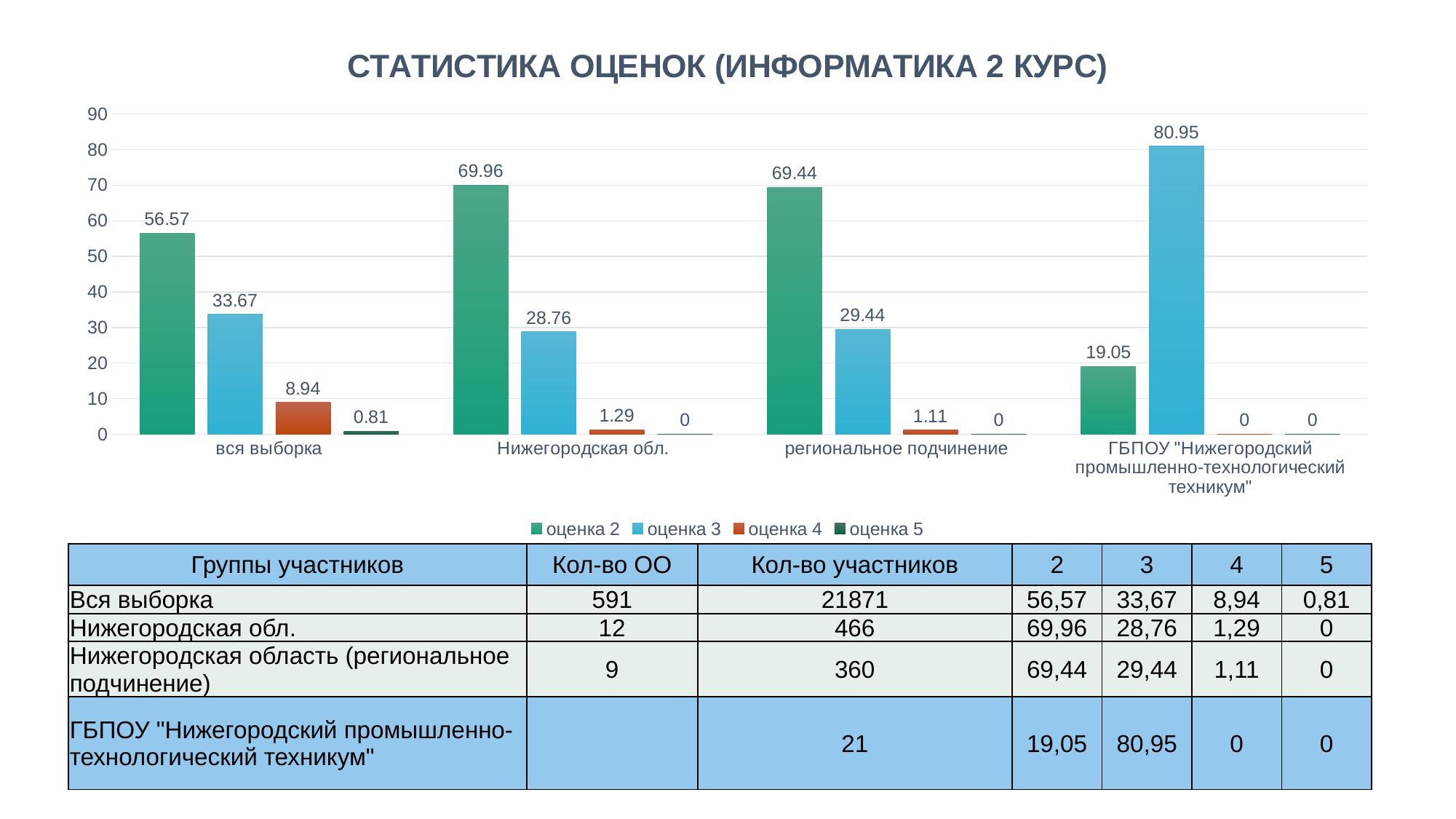
What is the difference between оценка 2 and оценка 3 for региональное подчинение? 40 What kind of chart is shown on the slide? bar chart What is the value of оценка 3 for ГБПОУ "Нижегородский промышленно-технологический техникум"? 80.95 What is the value of оценка 5 for вся выборка? 0.81 Which category has the lowest value for оценка 2? ГБПОУ "Нижегородский промышленно-технологический техникум" How many categories are shown on the x axis? 4 What is the value of оценка 2 for вся выборка? 56.57 Is the value of оценка 2 for ГБПОУ "Нижегородский промышленно-технологический техникум" greater or less than 20? less Which is larger for Нижегородская обл.: оценка 2 or оценка 3? оценка 2 What is the value of оценка 4 for Нижегородская обл.? 1.29 Which category has the highest value for оценка 3? ГБПОУ "Нижегородский промышленно-технологический техникум" How many series does the legend list? 4